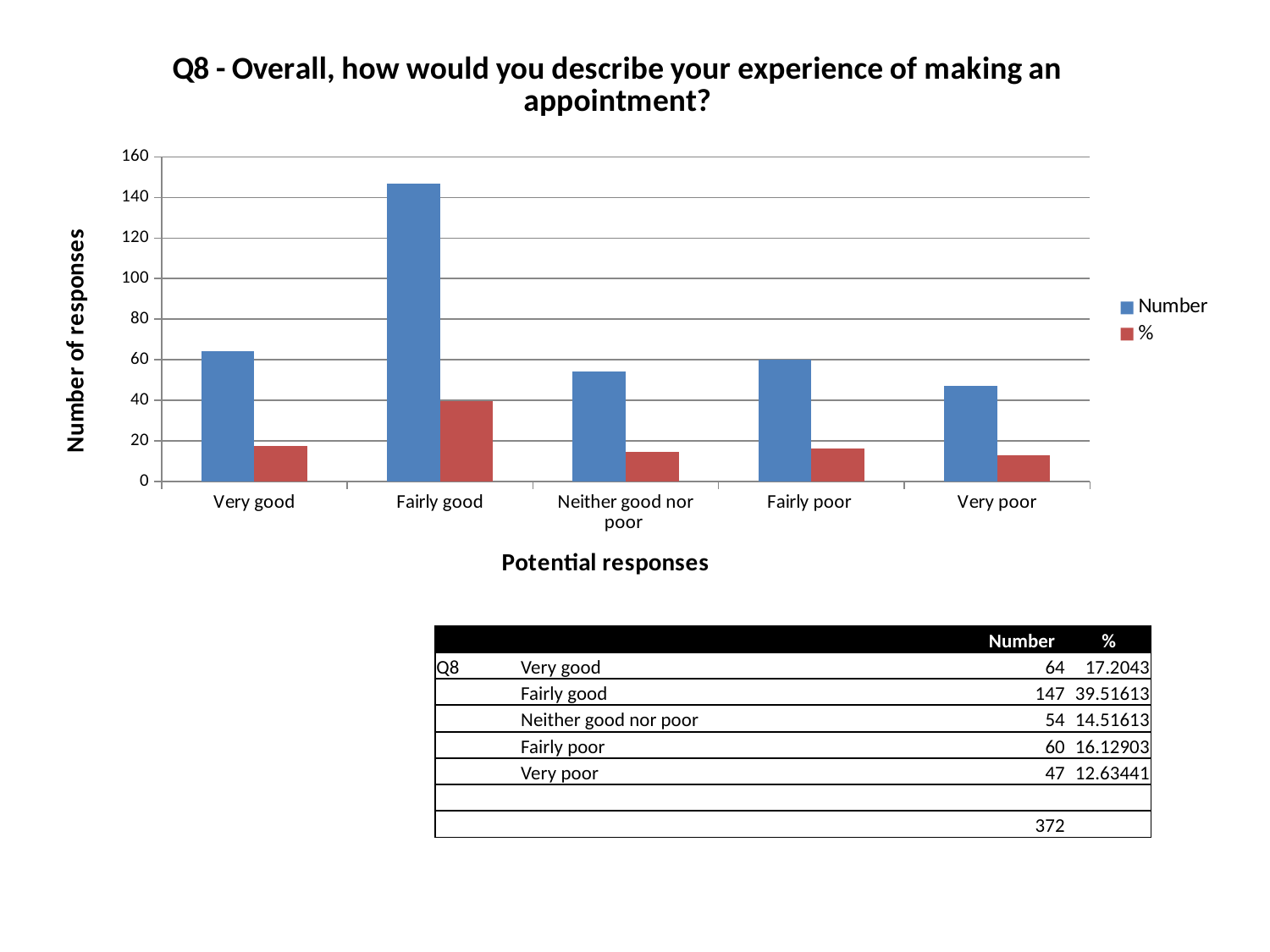
Which has a larger Number of responses, Very good or Fairly poor? Very good Is the Number value for Fairly good greater or less than 140? greater How many series does the legend list? 2 What is the Number value for Fairly good? 147 What is the Number value for Very poor? 47 Which response category has the highest Number of responses? Fairly good What kind of chart is shown on the slide? bar chart What is the % value for Neither good nor poor? 14.51613 How many response categories are shown on the x axis? 5 What is the title of the y axis? Number of responses Which response category has the lowest Number of responses? Very poor What is the difference in Number between Fairly good and Very good? 83